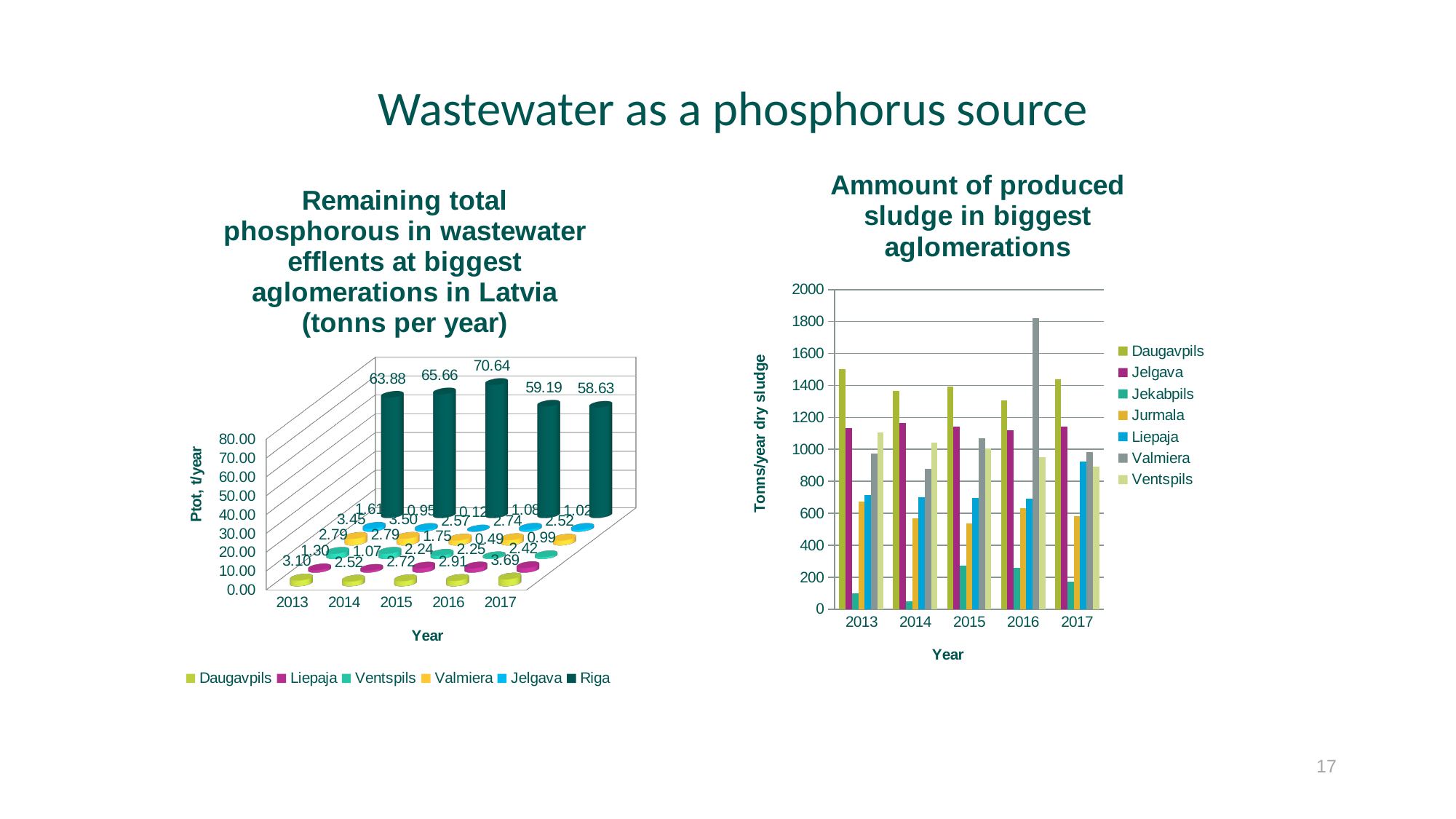
In the left chart (Remaining total phosphorous in wastewater efflents), in which year is the Riga value highest? 2015 In the left chart (Remaining total phosphorous in wastewater efflents), what is the value for Riga in 2015? 70.64 In the left chart (Remaining total phosphorous in wastewater efflents), in which year is the Riga value lowest? 2017 In the right chart (Ammount of produced sludge in biggest aglomerations), how many series does the legend list? 7 In the left chart (Remaining total phosphorous in wastewater efflents), what is the difference between the Riga values for 2015 and 2016? 11.45 In the left chart (Remaining total phosphorous in wastewater efflents), what is the value for Riga in 2017? 58.63 In the left chart (Remaining total phosphorous in wastewater efflents), how many years are shown on the x axis? 5 In the right chart (Ammount of produced sludge in biggest aglomerations), which series has the tallest bar in 2016? Valmiera In the right chart (Ammount of produced sludge in biggest aglomerations), is the value for Valmiera in 2016 greater or less than 1600? greater In the left chart (Remaining total phosphorous in wastewater efflents), how many series does the legend list? 6 In the right chart (Ammount of produced sludge in biggest aglomerations), is the value for Jekabpils in 2014 greater or less than 200? less What kind of chart is the right chart (Ammount of produced sludge in biggest aglomerations)? bar chart